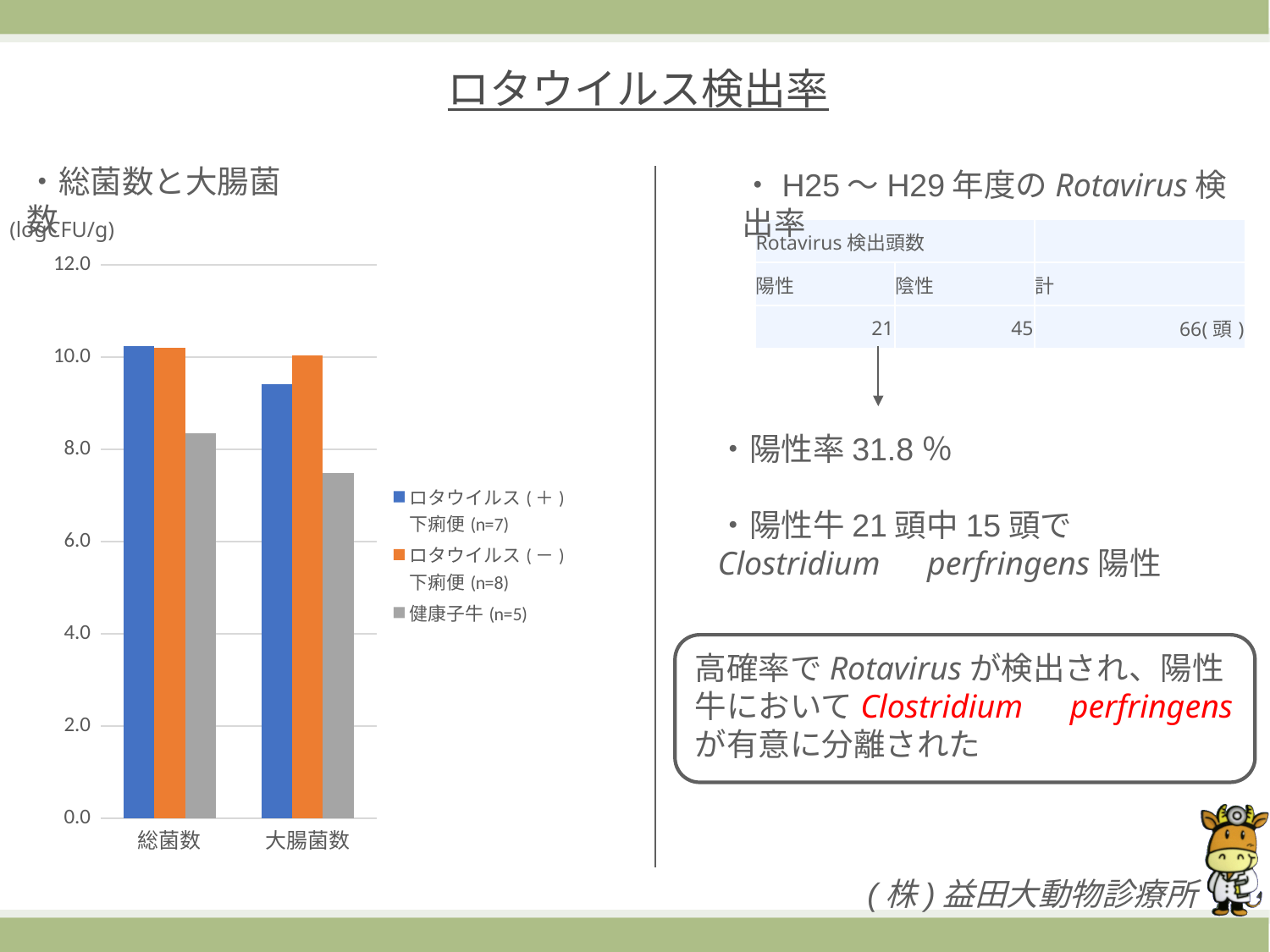
In the 大腸菌数 category, which is larger: ロタウイルス(+)下痢便 (n=7) or ロタウイルス(−)下痢便 (n=8)? ロタウイルス(−)下痢便 (n=8) Is the value for ロタウイルス(+)下痢便 (n=7) in the 大腸菌数 category greater or less than 10.0? less What kind of chart is shown on the slide? bar chart Which series has the lowest value in the 総菌数 category? 健康子牛 (n=5) How many series does the legend of the bar chart list? 3 Is the value for 健康子牛 (n=5) in the 大腸菌数 category greater or less than 8.0? less What unit is shown for the y axis of the bar chart? logCFU/g Which series has the highest value in the 大腸菌数 category? ロタウイルス(−)下痢便 (n=8) How many categories are shown on the x axis of the bar chart? 2 Is the value for ロタウイルス(−)下痢便 (n=8) in the 総菌数 category greater or less than 10.0? greater For 健康子牛 (n=5), which category has the larger value: 総菌数 or 大腸菌数? 総菌数